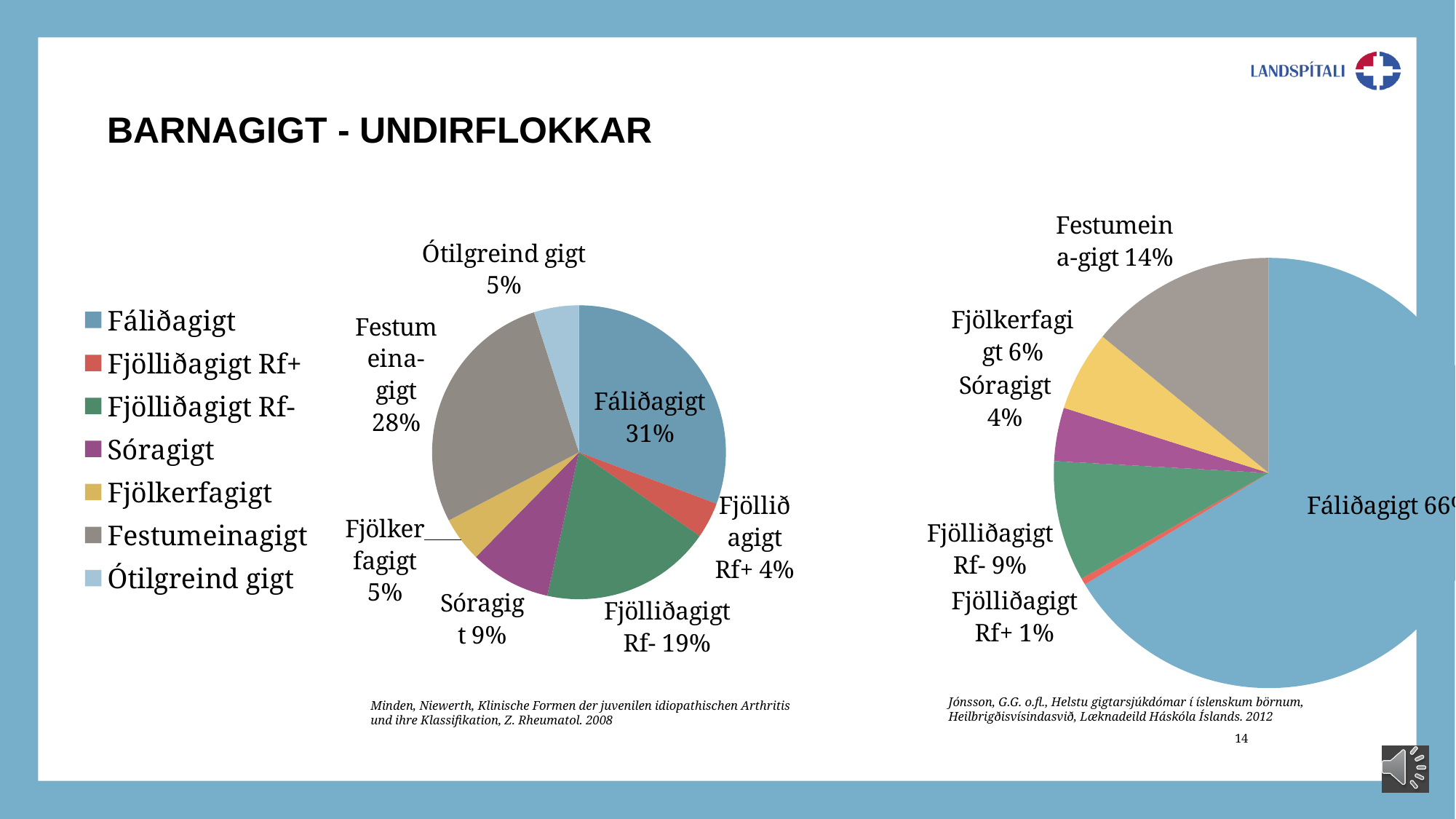
What kind of charts are shown on the slide? Pie charts On the right pie chart, what is the difference between the shares of Fjölliðagigt Rf- and Sóragigt? 5% On the right pie chart, what share is Fjölliðagigt Rf+? 1% On the left pie chart, what share is Fjölliðagigt Rf-? 19% On the right pie chart, which category has the smallest share? Fjölliðagigt Rf+ On the left pie chart, what share is Festumeinagigt? 28% How many slices does the right pie chart have? 6 On the right pie chart, what share is Festumeinagigt? 14% On the left pie chart, which category has the largest share? Fáliðagigt On the left pie chart, what share is Fáliðagigt? 31% On the left pie chart, what is the difference between the shares of Fáliðagigt and Festumeinagigt? 3% On the left pie chart, which is larger, Sóragigt or Fjölliðagigt Rf+? Sóragigt